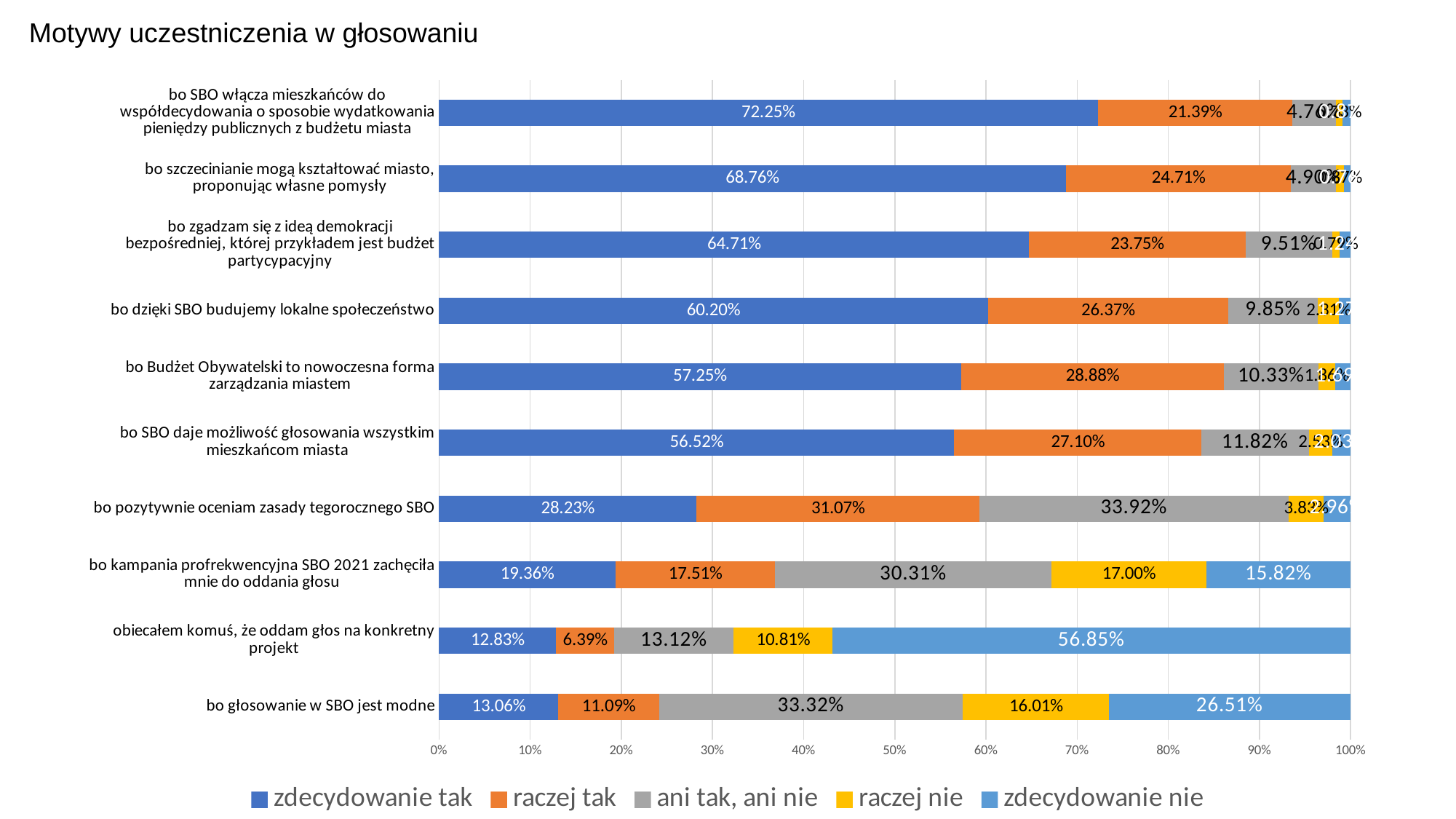
Which category has the highest 'zdecydowanie tak' value? bo SBO włącza mieszkańców do współdecydowania o sposobie wydatkowania pieniędzy publicznych z budżetu miasta How many series does the legend list? 5 What is the difference between the 'zdecydowanie tak' values for 'bo szczecinianie mogą kształtować miasto, proponując własne pomysły' and 'bo zgadzam się z ideą demokracji bezpośredniej, której przykładem jest budżet partycypacyjny'? 4.05% Which category has the lowest 'raczej tak' value? obiecałem komuś, że oddam głos na konkretny projekt What is the 'zdecydowanie tak' value for 'bo SBO włącza mieszkańców do współdecydowania o sposobie wydatkowania pieniędzy publicznych z budżetu miasta'? 72.25% How many categories (motives) are plotted on the chart? 10 What type of chart is shown on the slide? stacked bar chart What is the 'zdecydowanie nie' value for 'obiecałem komuś, że oddam głos na konkretny projekt'? 56.85% What is the 'raczej nie' value for 'bo kampania profrekwencyjna SBO 2021 zachęciła mnie do oddania głosu'? 17.00% Which is larger: the 'zdecydowanie nie' value for 'bo głosowanie w SBO jest modne' or for 'bo kampania profrekwencyjna SBO 2021 zachęciła mnie do oddania głosu'? bo głosowanie w SBO jest modne What is the 'ani tak, ani nie' value for 'bo pozytywnie oceniam zasady tegorocznego SBO'? 33.92% What colour represents the 'raczej nie' series in the legend? yellow